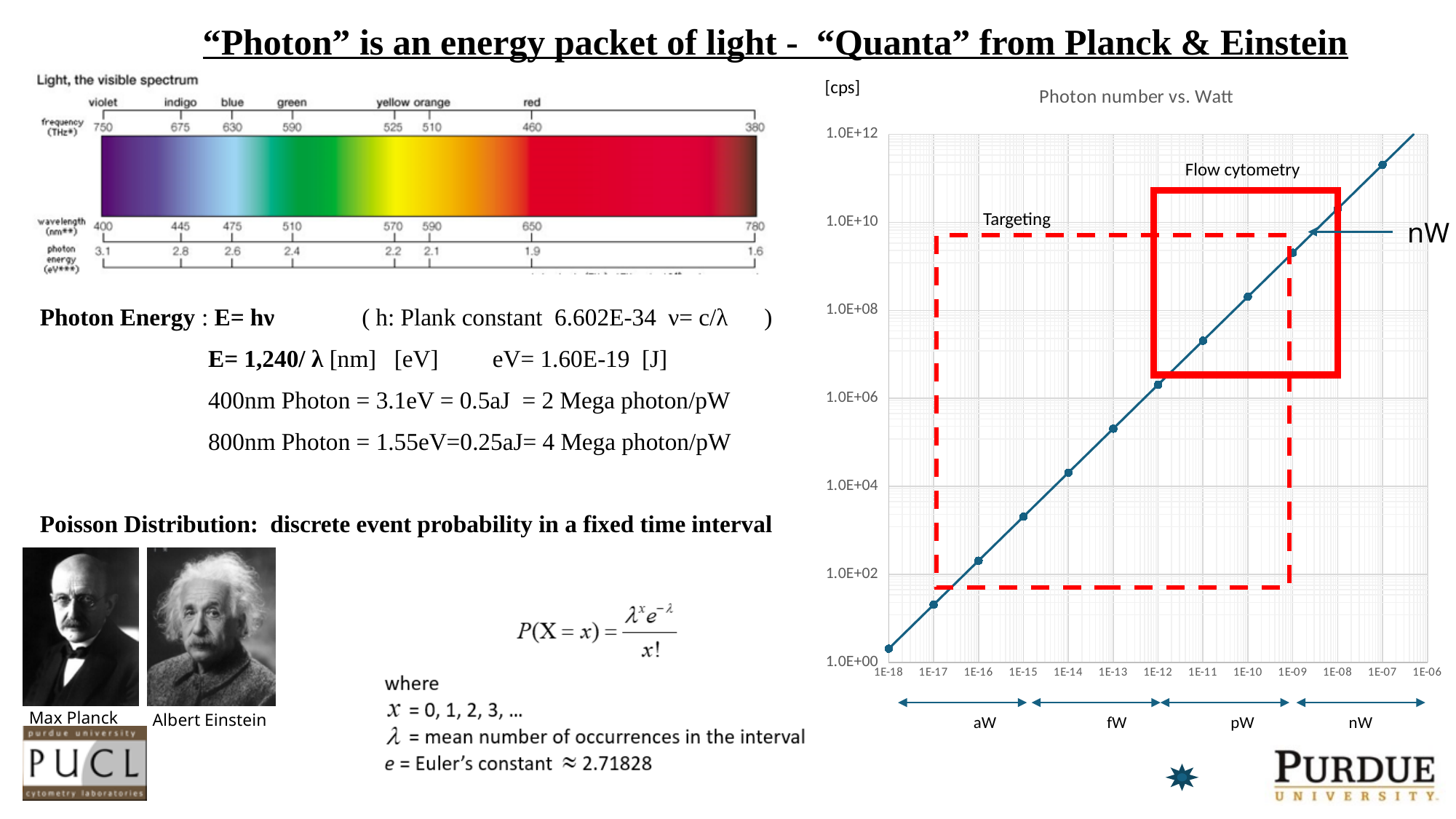
In the "Photon number vs. Watt" chart, is the value at 1E-15 greater or less than 1.0E+04? less In the "Photon number vs. Watt" chart, is the value at 1E-09 greater or less than 1.0E+08? greater What is the title of the chart on the right side of the slide? Photon number vs. Watt In the "Photon number vs. Watt" chart, which has the larger value: the point at 1E-10 or the point at 1E-14? 1E-10 What kind of chart is the "Photon number vs. Watt" chart? line chart In the "Photon number vs. Watt" chart, which has the larger value: the point at 1E-16 or the point at 1E-12? 1E-12 In the "Photon number vs. Watt" chart, is the value at 1E-07 greater or less than 1.0E+10? greater What unit label is shown at the top of the y-axis of the "Photon number vs. Watt" chart? [cps] In the "Photon number vs. Watt" chart, do the plotted values rise or fall as the x-axis value increases from 1E-18 to 1E-06? rise In the "Photon number vs. Watt" chart, at which x-axis value is the lowest plotted point? 1E-18